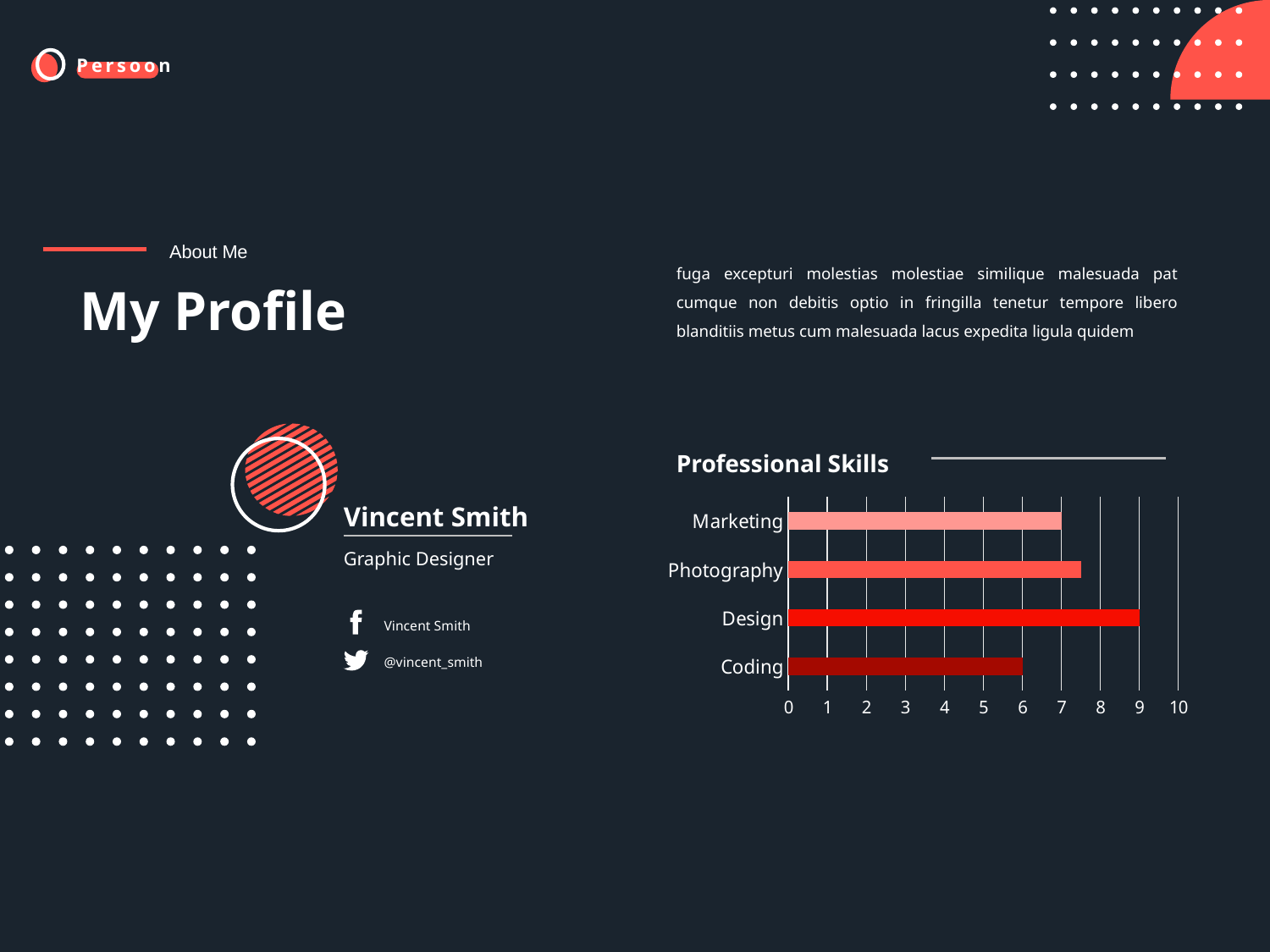
Which skill has the highest value in the Professional Skills chart? Design What is the value for Coding in the Professional Skills chart? 6 Is the value for Photography greater or less than 8 in the Professional Skills chart? less Which skill has the lowest value in the Professional Skills chart? Coding Which is larger in the Professional Skills chart, Design or Coding? Design What is the value for Marketing in the Professional Skills chart? 7 Is the value for Photography greater or less than 7 in the Professional Skills chart? greater How many skill categories are plotted in the Professional Skills chart? 4 What is the title of the chart on the slide? Professional Skills What type of chart is shown under the heading Professional Skills? bar chart What is the value for Design in the Professional Skills chart? 9 What is the difference between the values for Design and Coding in the Professional Skills chart? 3